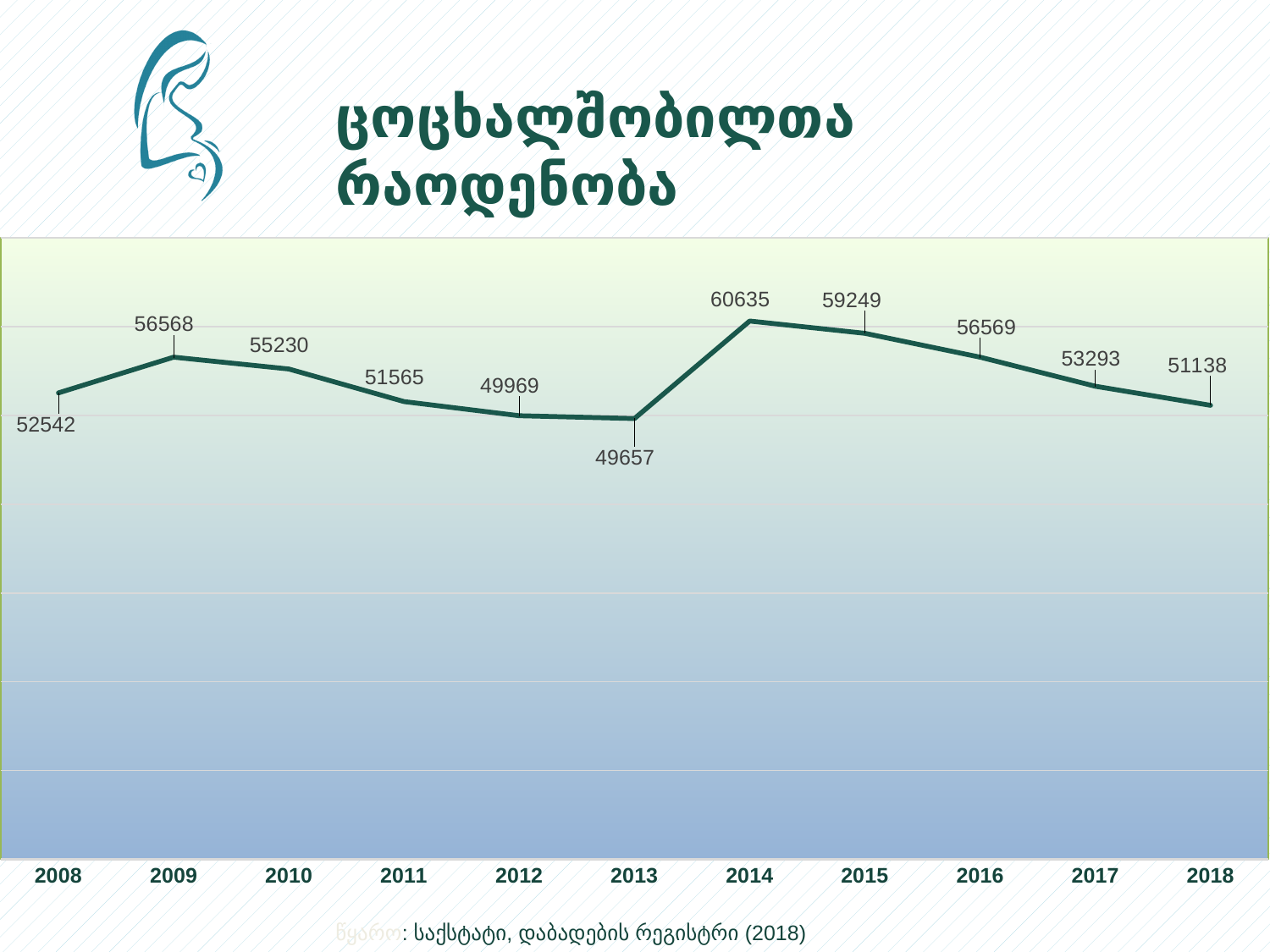
What is the difference between the values for 2014 and 2013? 10978 How many years are plotted on the x axis? 11 Do the values rise or fall from 2014 to 2018? fall What is the value for 2018? 51138 What is the value for 2008? 52542 What is the value for 2014? 60635 Which is larger, the value for 2015 or the value for 2017? 2015 Which year has the lowest value? 2013 What is the value for 2011? 51565 What kind of chart is shown on the slide? line chart What is the difference between the values for 2009 and 2008? 4026 Which year has the highest value? 2014